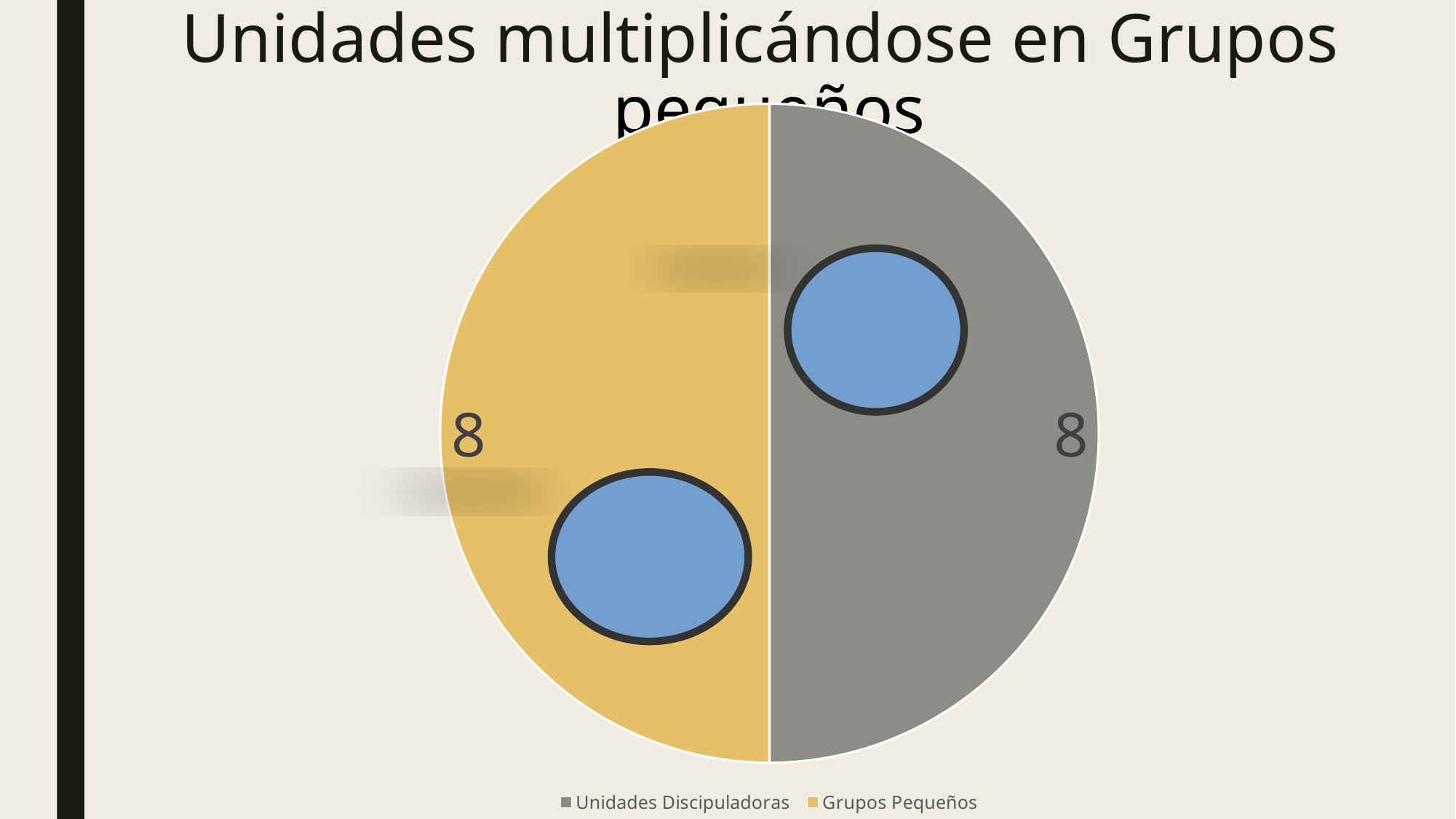
What kind of chart is shown on the slide? pie chart What is the value for Grupos Pequeños? 8 What is the title of the chart? Unidades multiplicándose en Grupos pequeños What share of the pie does Unidades Discipuladoras represent? 50% What is the value for Unidades Discipuladoras? 8 What is the total of the two slice values? 16 What share of the pie does Grupos Pequeños represent? 50% How many slices does the pie chart have? 2 What is the difference between the values for Unidades Discipuladoras and Grupos Pequeños? 0 How many entries does the legend list? 2 Which colour represents Grupos Pequeños in the pie chart? yellow